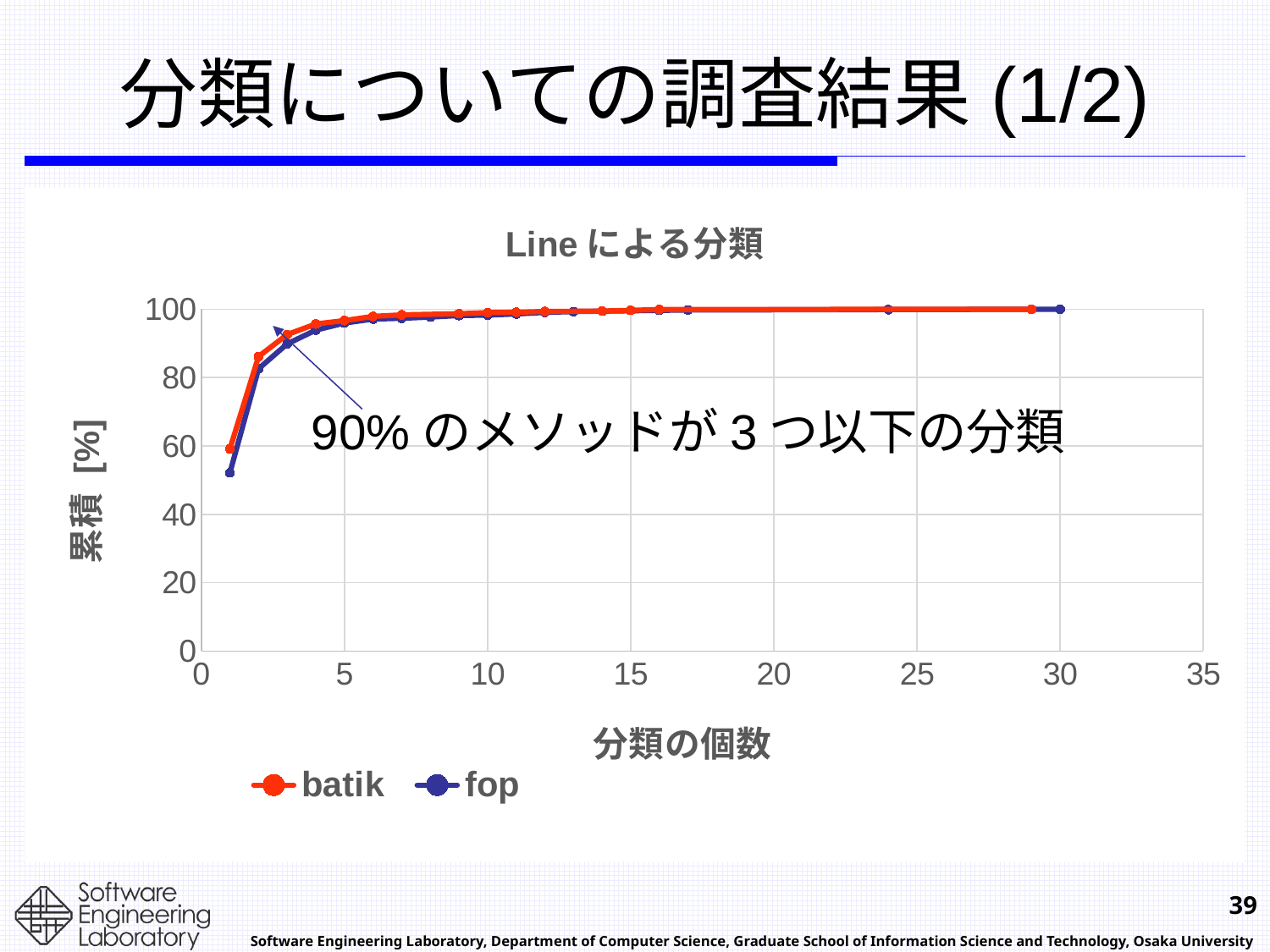
What are the two series named in the legend? batik and fop Do the values of the batik series rise or fall as the x axis increases? rise Is the value for fop at 1 on the x axis greater or less than 60? less Do the values of the fop series rise or fall as the x axis increases? rise What is the title of the chart? Line による分類 How many series does the legend list? 2 Is the value for batik at 1 on the x axis greater or less than 40? greater At 1 on the x axis, which series has the higher value, batik or fop? batik Is the value for fop at 1 on the x axis greater or less than 40? greater What kind of chart is shown on the slide? line chart